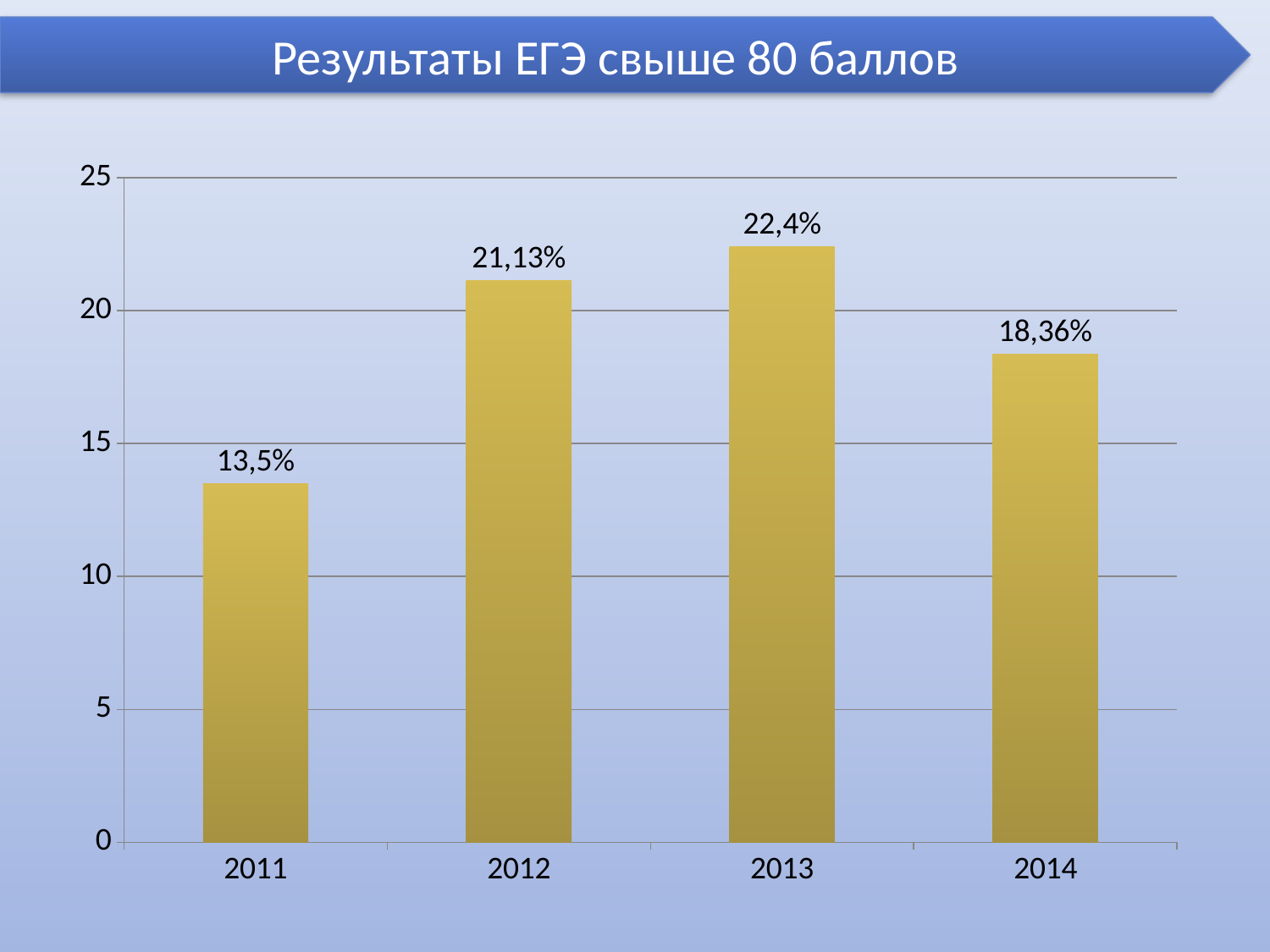
Which year has the lowest value? 2011 Which is larger, the value for 2012 or the value for 2014? 2012 What is the difference between the values for 2013 and 2011? 8,9% Which year has the highest value? 2013 How many years are shown on the chart? 4 What kind of chart is shown on the slide? bar chart Is the value for 2011 greater or less than 15? less What is the value for 2014? 18,36% What is the value for 2011? 13,5% What is the title of the chart? Результаты ЕГЭ свыше 80 баллов What is the difference between the values for 2012 and 2014? 2,77% What is the value for 2013? 22,4%